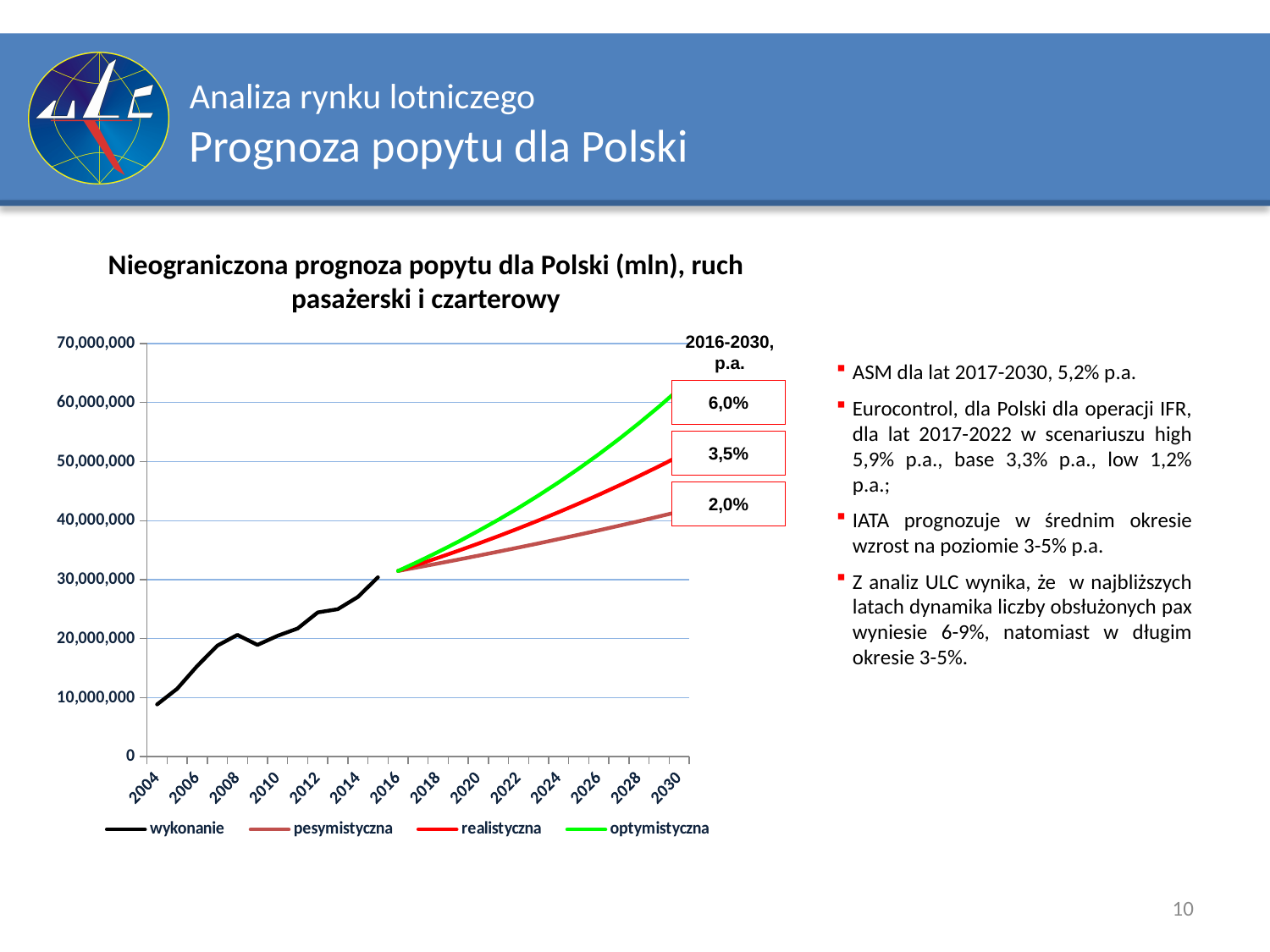
How many series does the chart legend list? 4 Which forecast series has the lowest value in 2030? pesymistyczna Does the wykonanie series generally rise or fall from 2004 to 2015? rise What annual growth rate (p.a.) for 2016-2030 is shown for the realistyczna scenario? 3,5% Is the value for optymistyczna in 2030 greater or less than 50,000,000? greater Is the value for pesymistyczna in 2030 greater or less than 50,000,000? less In 2030, which is larger: the realistyczna value or the pesymistyczna value? realistyczna Which series has the highest value in 2030? optymistyczna Is the value for wykonanie in 2004 greater or less than 20,000,000? less What kind of chart is shown on the slide? line chart What annual growth rate (p.a.) for 2016-2030 is shown for the optymistyczna scenario? 6,0% What is the title of the chart? Nieograniczona prognoza popytu dla Polski (mln), ruch pasażerski i czarterowy